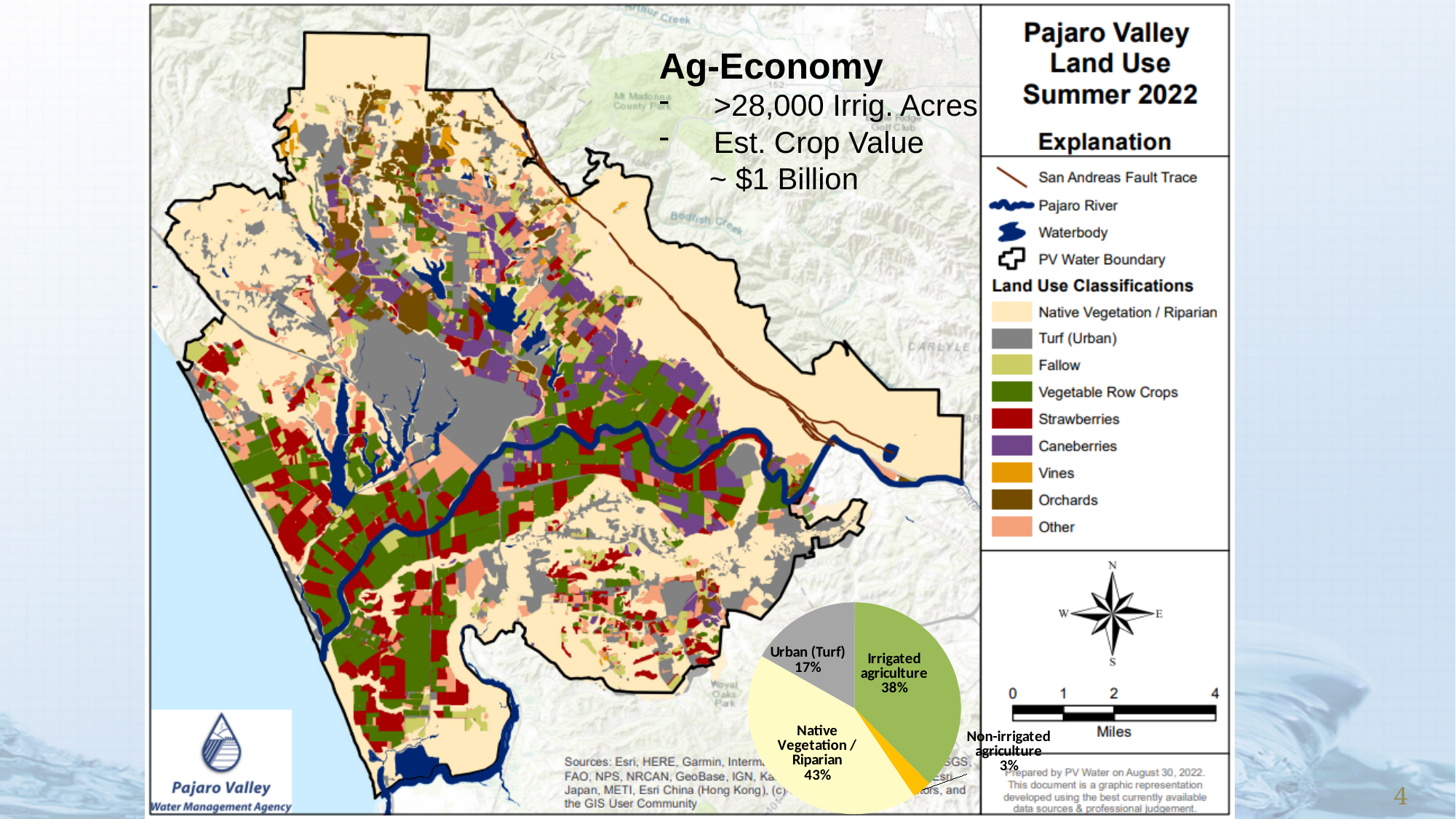
What colour is the Irrigated agriculture slice in the pie chart? Green Which slice of the pie chart is the largest? Native Vegetation / Riparian What share of the pie chart is Native Vegetation / Riparian? 43% What kind of chart is shown in the lower right of the map? Pie chart What share of the pie chart is Non-irrigated agriculture? 3% Which slice of the pie chart is the smallest? Non-irrigated agriculture In the pie chart, which is larger: Urban (Turf) or Irrigated agriculture? Irrigated agriculture What share of the pie chart is Irrigated agriculture? 38% What share of the pie chart is Urban (Turf)? 17% What is the combined share of Irrigated agriculture and Non-irrigated agriculture in the pie chart? 41% How many slices does the pie chart have? 4 What is the difference in percentage points between Native Vegetation / Riparian and Irrigated agriculture in the pie chart? 5